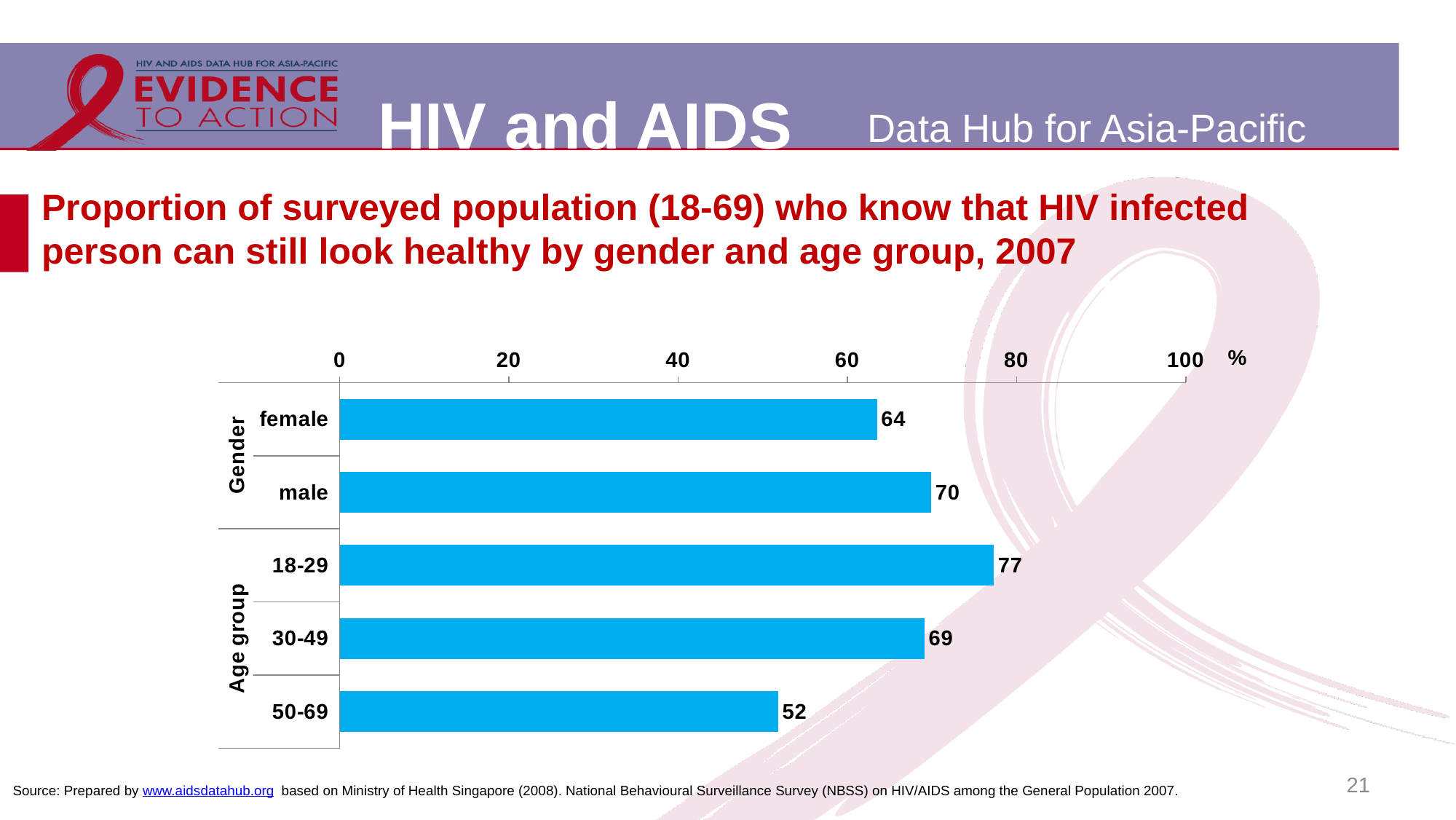
What is the value for female? 64 What is the difference between the values for the 18-29 and 50-69 age groups? 25 Is the value for the 18-29 age group greater or less than 60? greater How many categories are plotted in the chart? 5 What is the value for the 30-49 age group? 69 Which is larger, the value for male or the value for female? male What is the value for the 50-69 age group? 52 What kind of chart is shown on the slide? bar chart What unit is shown at the end of the horizontal axis? % Which category has the lowest value? 50-69 Which category has the highest value? 18-29 What is the difference between the values for male and female? 6